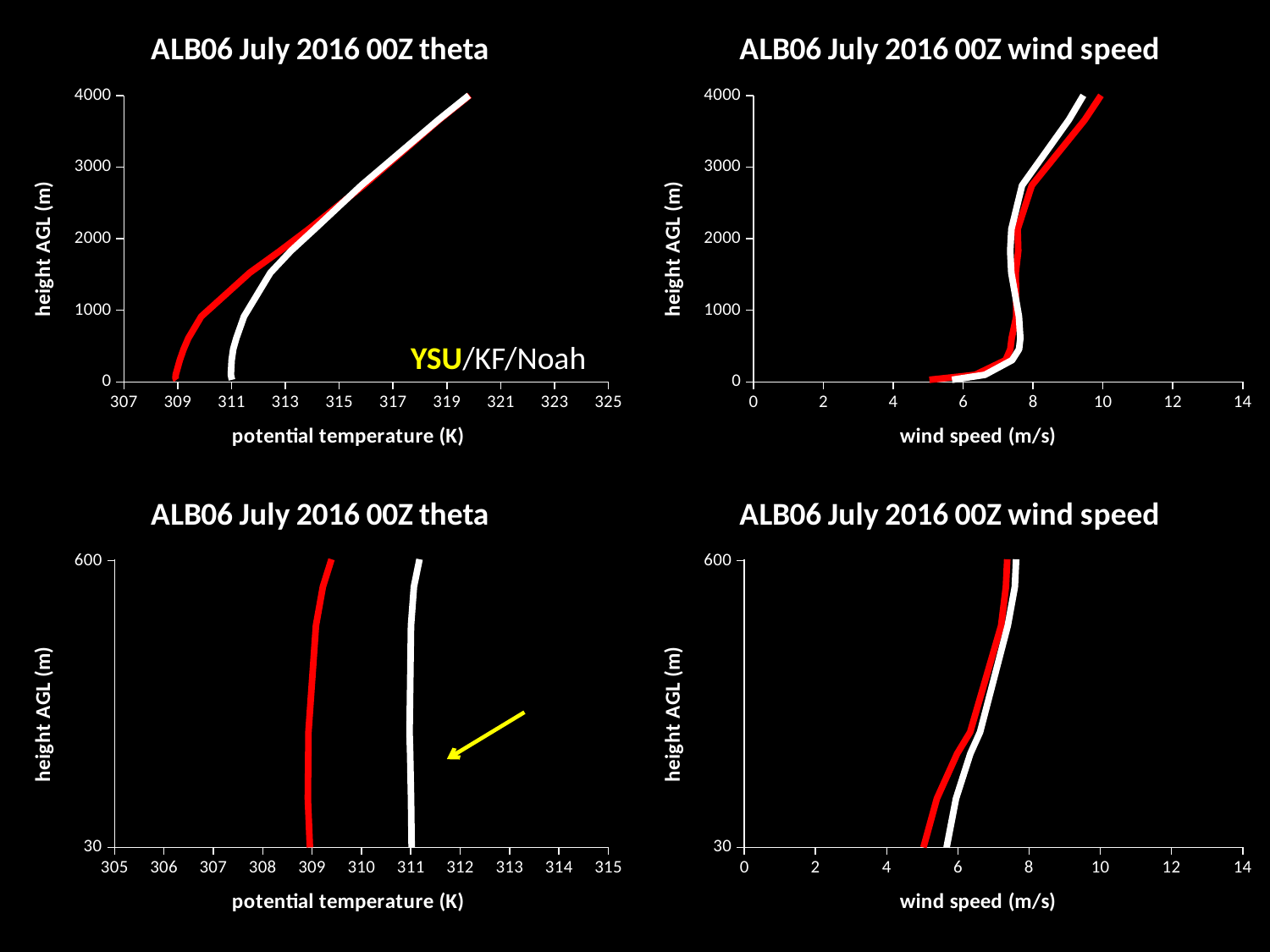
What is the x-axis label of the top-right chart titled 'ALB06 July 2016 00Z wind speed'? wind speed (m/s) In the top-left chart titled 'ALB06 July 2016 00Z theta', does potential temperature increase or decrease with height? increase In the top-right chart titled 'ALB06 July 2016 00Z wind speed', is the wind speed of the red line at 4000 m height greater or less than 8 m/s? greater How many charts are shown on the slide? 4 In the bottom-right chart titled 'ALB06 July 2016 00Z wind speed', is the wind speed of the red line at 600 m height greater or less than 6 m/s? greater In the bottom-left chart titled 'ALB06 July 2016 00Z theta', is the potential temperature of the white line at 30 m height greater or less than 310 K? greater What is the y-axis label of the bottom-left chart titled 'ALB06 July 2016 00Z theta'? height AGL (m) In the bottom-left chart titled 'ALB06 July 2016 00Z theta', which line has the higher potential temperature at 30 m height, the red line or the white line? white line What kind of chart is the top-left chart titled 'ALB06 July 2016 00Z theta'? line chart